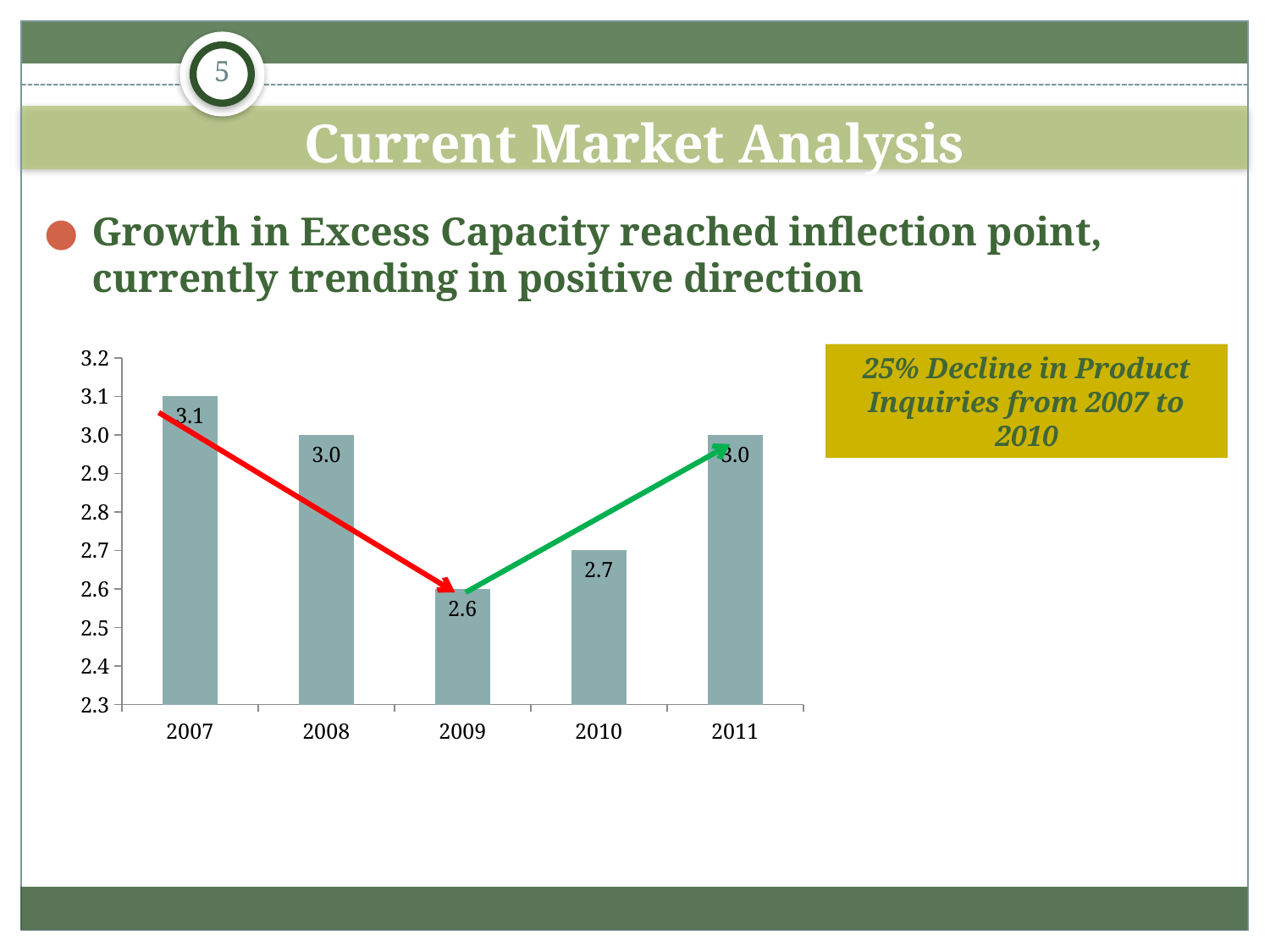
Which year has the lowest value? 2009 Is the value for 2010 greater or less than 2.8? less What is the difference between the values for 2007 and 2009? 0.5 What is the value for 2010? 2.7 Which is larger, the value for 2008 or the value for 2010? 2008 What is the value for 2007? 3.1 How many years are shown on the x axis? 5 Which year has the highest value? 2007 Do the values rise or fall from 2009 to 2011? rise What is the value for 2009? 2.6 What is the value for 2011? 3.0 What kind of chart is shown on the slide? bar chart